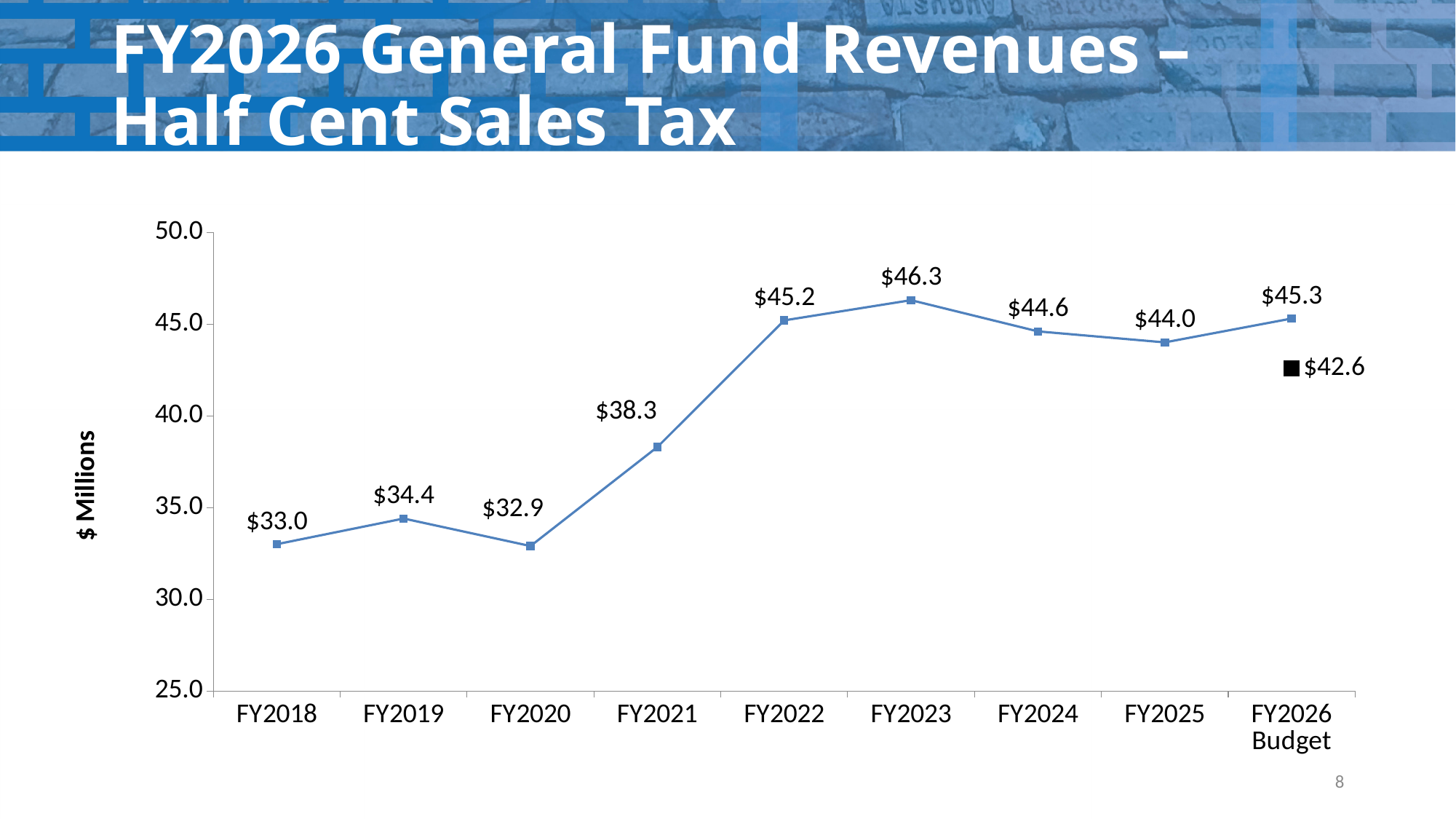
What is the difference between the FY2022 value and the FY2021 value? $6.9 Which is larger, the value for FY2024 or the value for FY2025? FY2024 What is the value for FY2021? $38.3 Which fiscal year has the lowest value on the line? FY2020 How many fiscal years are shown on the x axis? 9 What kind of chart is shown on the slide? line chart What is the value for FY2023? $46.3 What is the label on the vertical axis? $ Millions What is the value of the blue line point for FY2026 Budget? $45.3 What value is shown by the black square marker at FY2026 Budget? $42.6 Which fiscal year has the highest value on the line? FY2023 Is the value for FY2019 greater or less than 35.0? less